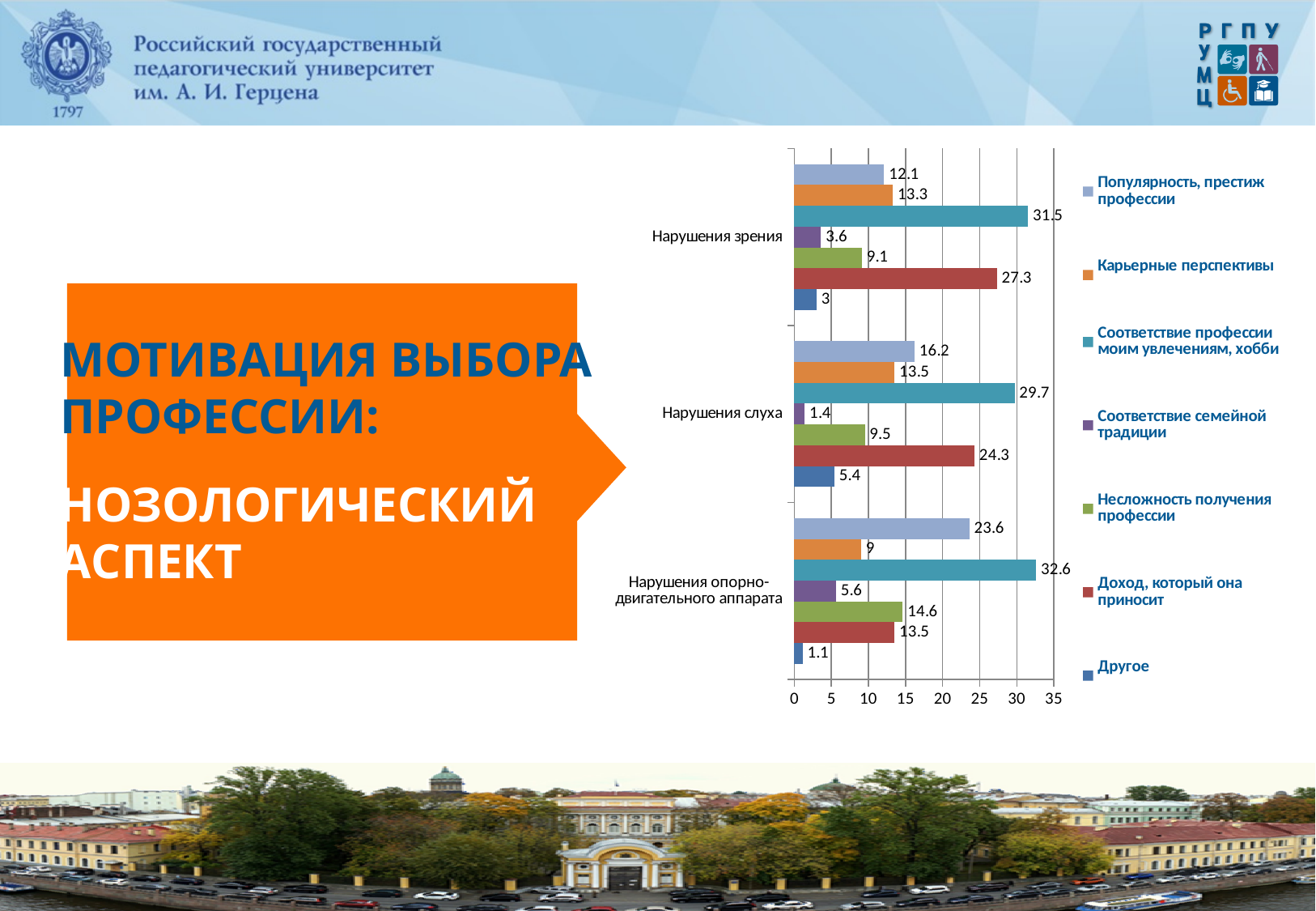
Is the value for "Несложность получения профессии" in the "Нарушения опорно-двигательного аппарата" category greater or less than 10? greater What is the value for "Другое" in the "Нарушения опорно-двигательного аппарата" category? 1.1 What is the difference between "Соответствие профессии моим увлечениям, хобби" and "Доход, который она приносит" in the "Нарушения зрения" category? 4.2 How many categories are shown on the chart? 3 How many series does the legend list? 7 Which series has the lowest value in the "Нарушения слуха" category? Соответствие семейной традиции Which series has the highest value in the "Нарушения опорно-двигательного аппарата" category? Соответствие профессии моим увлечениям, хобби What is the value for "Популярность, престиж профессии" in the "Нарушения опорно-двигательного аппарата" category? 23.6 What is the value for "Соответствие профессии моим увлечениям, хобби" in the "Нарушения зрения" category? 31.5 What is the value for "Доход, который она приносит" in the "Нарушения слуха" category? 24.3 Which is larger in the "Нарушения слуха" category: "Популярность, престиж профессии" or "Карьерные перспективы"? Популярность, престиж профессии What kind of chart is shown on the slide? bar chart